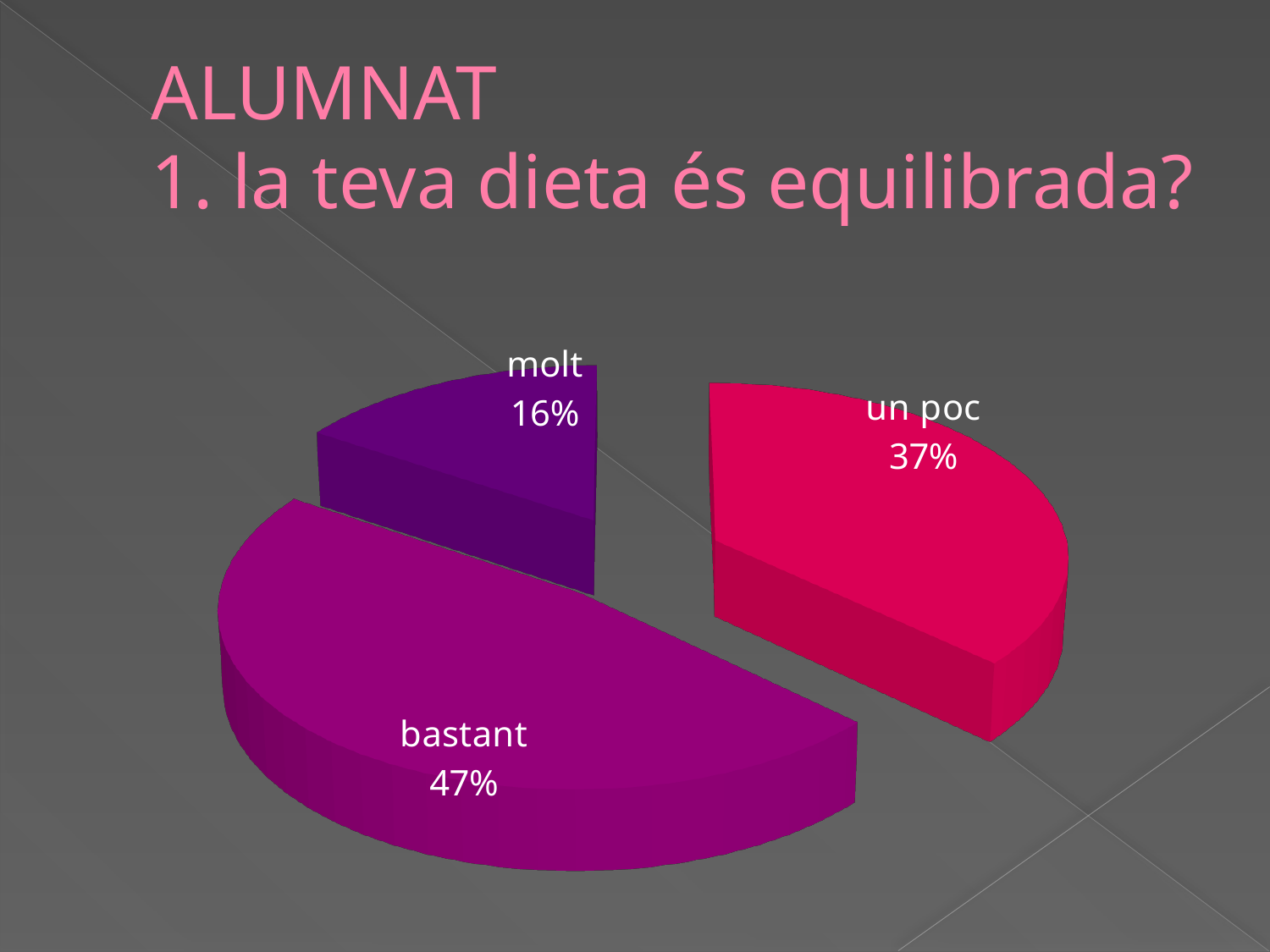
What share of the pie does the "molt" slice represent? 16% Which is larger, the share for "un poc" or the share for "molt"? un poc What is the difference in percentage points between "bastant" and "un poc"? 10 What kind of chart is shown on the slide? pie chart What question does the slide title say the chart is about? 1. la teva dieta és equilibrada? What percentage is shown for "molt"? 16% What percentage is shown for "un poc"? 37% What percentage is shown for "bastant"? 47% What is the difference in percentage points between "un poc" and "molt"? 21 Which category has the largest share of the pie? bastant How many slices does the pie chart have? 3 Which category has the smallest share of the pie? molt